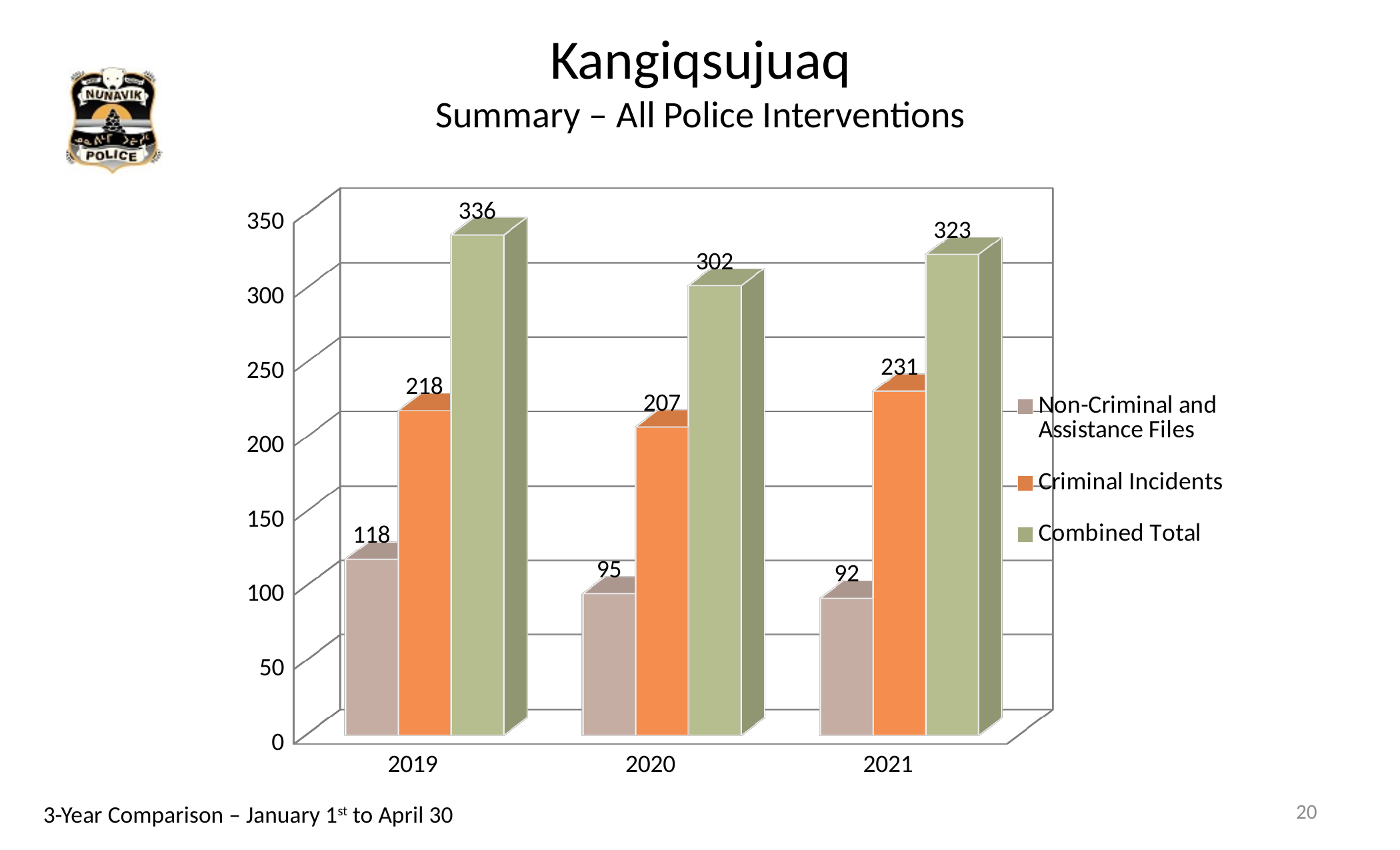
What is the Combined Total for 2020? 302 How many series does the legend list? 3 What kind of chart is shown on the slide? bar chart Which year has the highest Combined Total? 2019 What is the value for Criminal Incidents in 2021? 231 What is the value for Non-Criminal and Assistance Files in 2019? 118 Which year has the lowest value for Non-Criminal and Assistance Files? 2021 Is the value for Criminal Incidents in 2020 greater or less than 250? less Which is larger: Criminal Incidents in 2019 or Criminal Incidents in 2020? 2019 How many years are shown on the x axis? 3 Do the values for Non-Criminal and Assistance Files rise or fall from 2019 to 2021? fall What is the difference between the Combined Total in 2019 and in 2020? 34